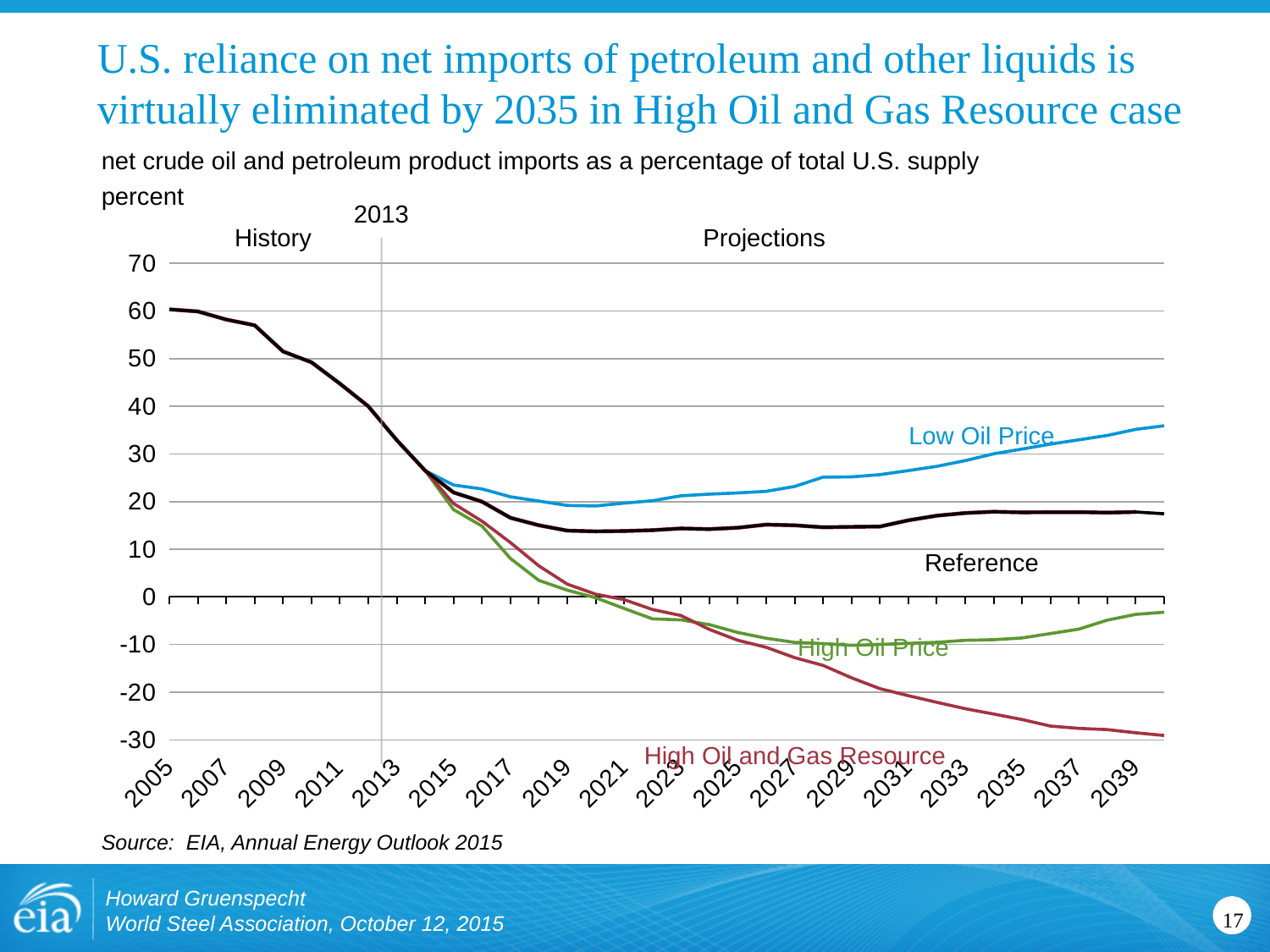
How many series (scenario lines) are plotted on the chart? 4 Which year does the vertical line separating History from Projections mark? 2013 Is the value for High Oil and Gas Resource in 2039 greater or less than -20? less Which series has the highest value in 2039? Low Oil Price Does the Low Oil Price line rise or fall between 2019 and 2039? rise Is the value for Low Oil Price in 2039 greater or less than 30? greater What kind of chart is shown on the slide? line chart Do the values fall or rise between 2005 and 2013 in the History period? fall Which series has the lowest value in 2039? High Oil and Gas Resource In 2035, which is larger: the High Oil Price value or the High Oil and Gas Resource value? High Oil Price Is the value for Reference in 2039 greater or less than 20? less